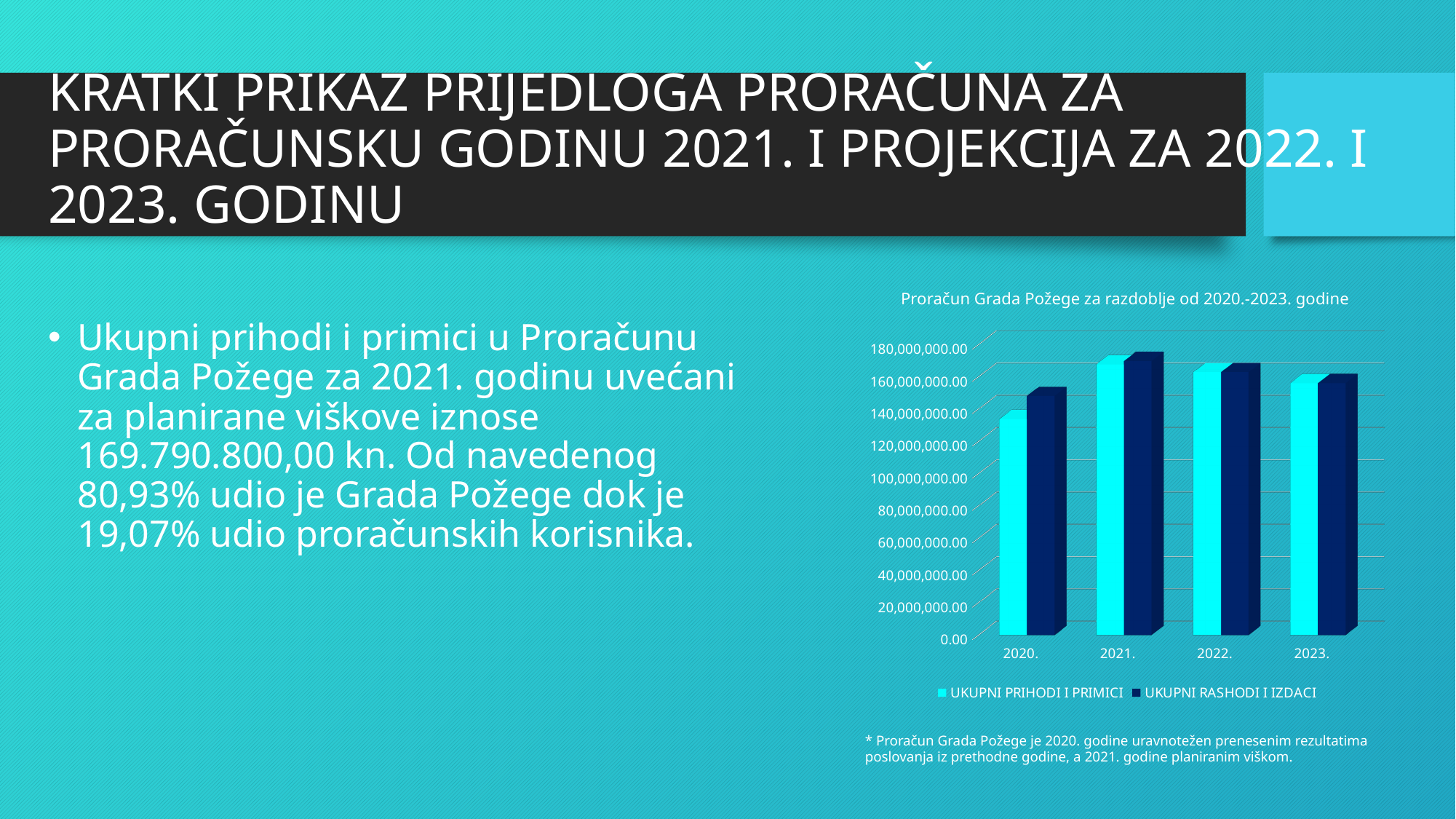
What is the title of the chart? Proračun Grada Požege za razdoblje od 2020.-2023. godine In which year is the value for UKUPNI PRIHODI I PRIMICI lowest? 2020. How many series does the chart legend list? 2 Which series is shown in dark blue in the chart? UKUPNI RASHODI I IZDACI Do the values for UKUPNI PRIHODI I PRIMICI rise or fall from 2021. to 2023.? fall In which year is the value for UKUPNI PRIHODI I PRIMICI highest? 2021. What kind of chart is shown on the slide? bar chart Is the value for UKUPNI PRIHODI I PRIMICI in 2021. greater or less than 160,000,000.00? greater For 2020., which is larger: UKUPNI PRIHODI I PRIMICI or UKUPNI RASHODI I IZDACI? UKUPNI RASHODI I IZDACI How many years (categories) are shown on the x axis of the chart? 4 Is the value for UKUPNI PRIHODI I PRIMICI in 2020. greater or less than 120,000,000.00? greater Is the value for UKUPNI RASHODI I IZDACI in 2023. greater or less than 180,000,000.00? less